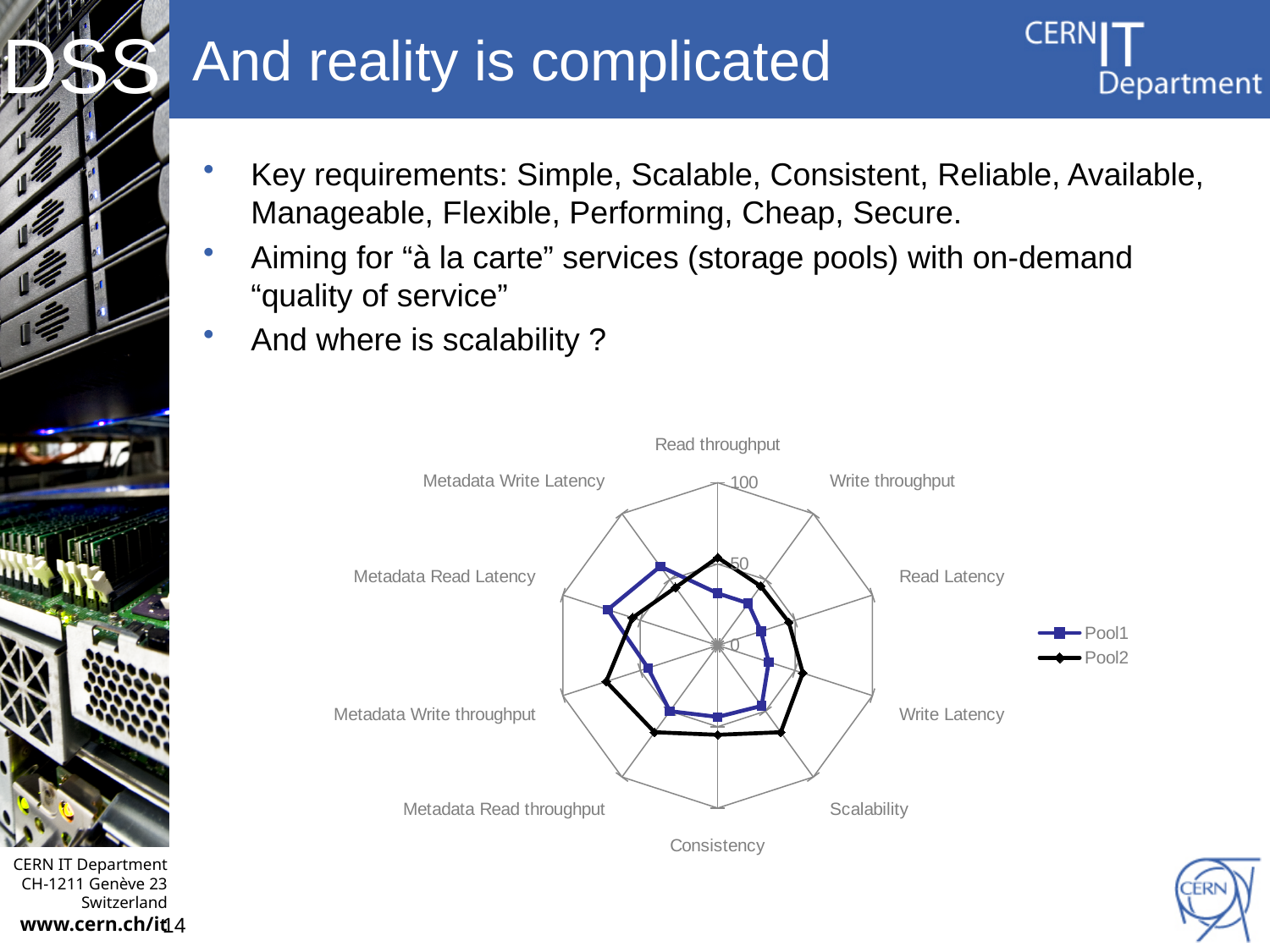
What is the maximum value shown on the radar chart's axis scale? 100 For Scalability, which series has the larger value, Pool1 or Pool2? Pool2 What kind of chart is shown on the slide? Radar chart Is the value of Pool1 for Write throughput greater or less than 50? less How many series does the chart legend list? 2 Is the value of Pool1 for Metadata Read Latency greater or less than 50? greater Is the value of Pool1 for Read throughput greater or less than 50? less For Metadata Read Latency, which series has the larger value, Pool1 or Pool2? Pool1 How many categories (axes) does the radar chart have? 10 Which series is drawn in blue with square markers? Pool1